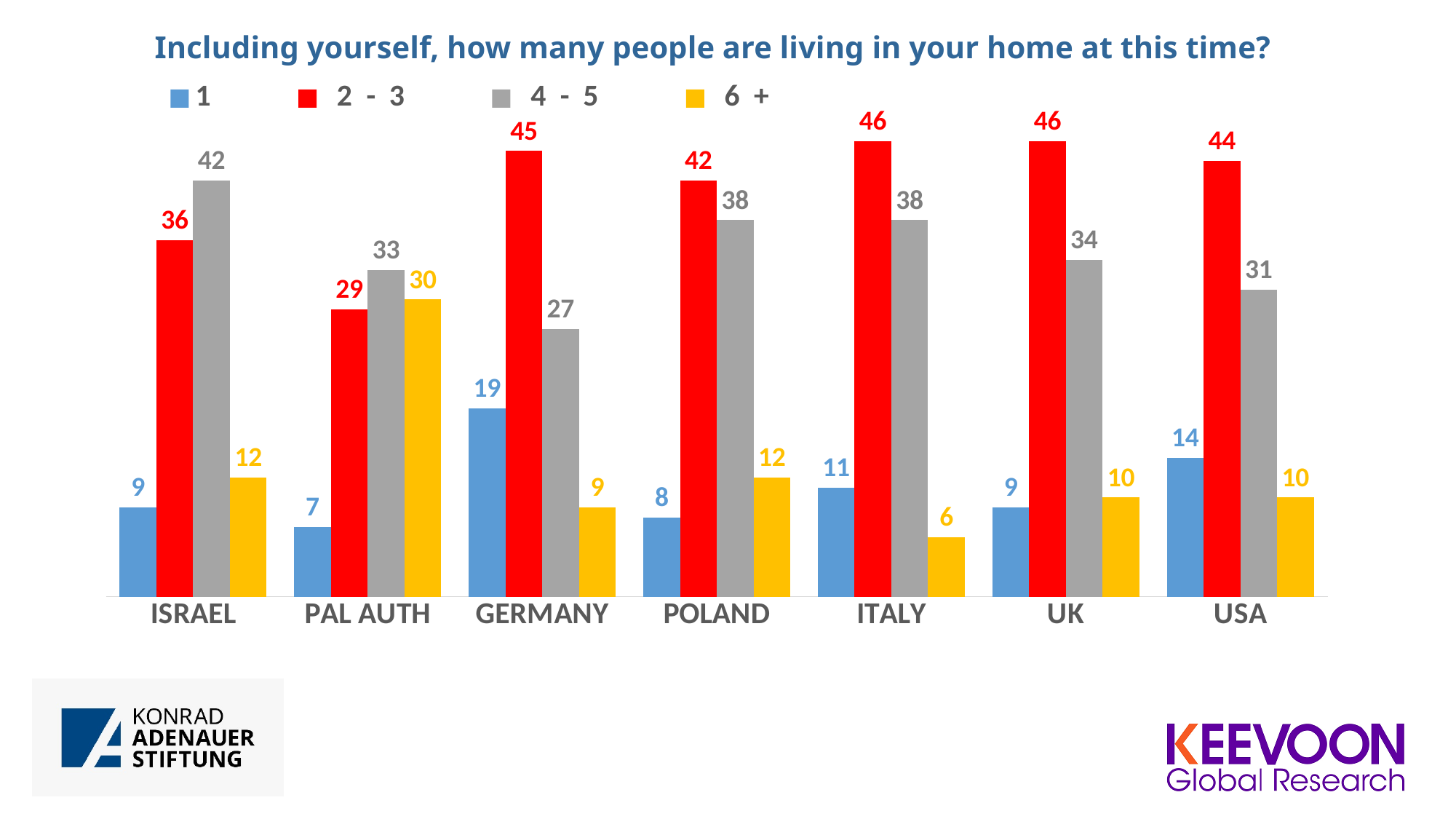
What is the value for the "6 +" series for PAL AUTH? 30 How many series does the legend list? 4 Which country has the lowest value for the "6 +" series? Italy How many countries are shown on the x axis? 7 What colour represents the "2 - 3" series in the chart? Red What is the value for the "1" series for USA? 14 Which is larger for Poland: the "2 - 3" value or the "4 - 5" value? 2 - 3 What kind of chart is shown on the slide? Bar chart Which country has the highest value for the "4 - 5" series? Israel What is the difference between the "2 - 3" value and the "4 - 5" value for Israel? 6 Which country has the highest value for the "1" series? Germany What is the value for the "2 - 3" series for Germany? 45